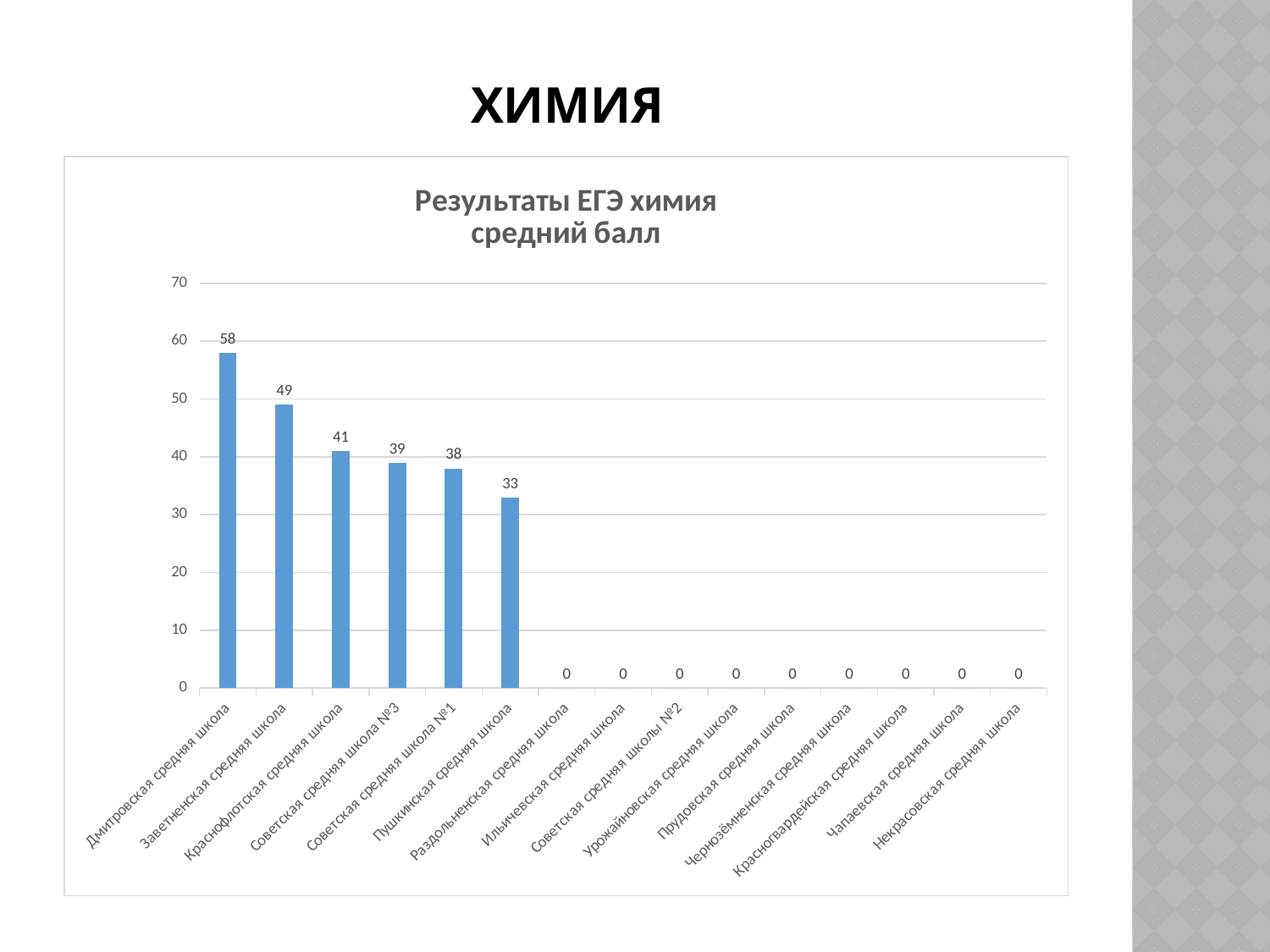
Which is larger, the score for Советская средняя школа №3 or for Советская средняя школа №1? Советская средняя школа №3 What is the average score for Дмитровская средняя школа? 58 What is the difference between the scores of Дмитровская средняя школа and Заветненская средняя школа? 9 What is the average score for Пушкинская средняя школа? 33 How many schools are shown on the x axis? 15 What type of chart is shown on the slide? Bar chart What is the difference between the scores of Краснофлотская средняя школа and Пушкинская средняя школа? 8 What is the average score for Советская средняя школа №1? 38 How many schools have a score of 0? 9 Is the value for Краснофлотская средняя школа greater or less than 40? greater Which school has the highest average chemistry score? Дмитровская средняя школа What is the average score for Заветненская средняя школа? 49